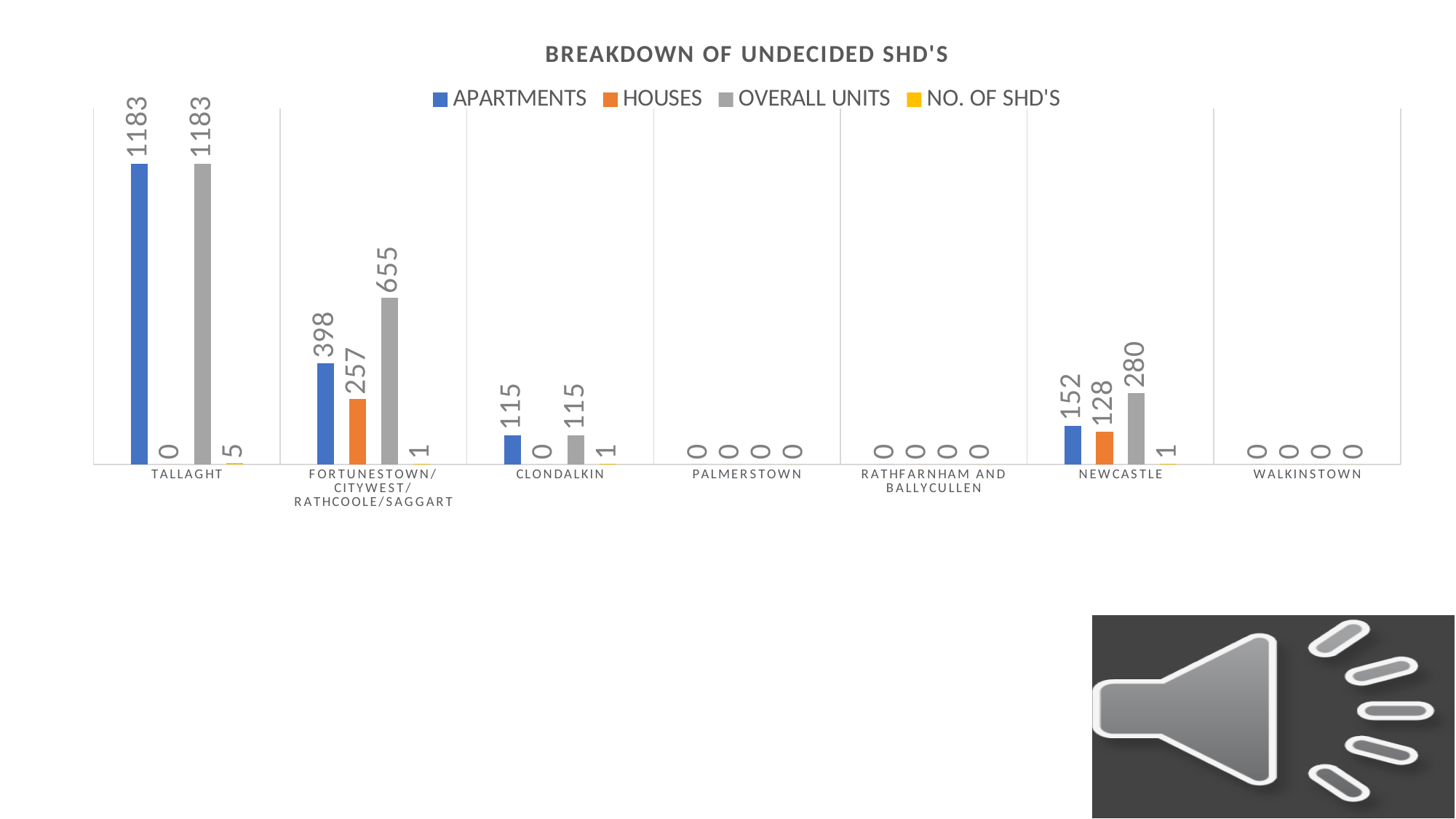
What is the value for HOUSES in FORTUNESTOWN/CITYWEST/RATHCOOLE/SAGGART? 257 What is the value for NO. OF SHD'S in TALLAGHT? 5 Which is larger, APARTMENTS in NEWCASTLE or APARTMENTS in CLONDALKIN? NEWCASTLE What is the title of the chart? BREAKDOWN OF UNDECIDED SHD'S What is the value for HOUSES in CLONDALKIN? 0 What is the difference between OVERALL UNITS and APARTMENTS in FORTUNESTOWN/CITYWEST/RATHCOOLE/SAGGART? 257 What kind of chart is shown? Bar chart What is the value for APARTMENTS in TALLAGHT? 1183 Which category has the highest value for OVERALL UNITS? TALLAGHT How many categories are shown on the x axis? 7 What is the value for OVERALL UNITS in NEWCASTLE? 280 How many series does the legend list? 4